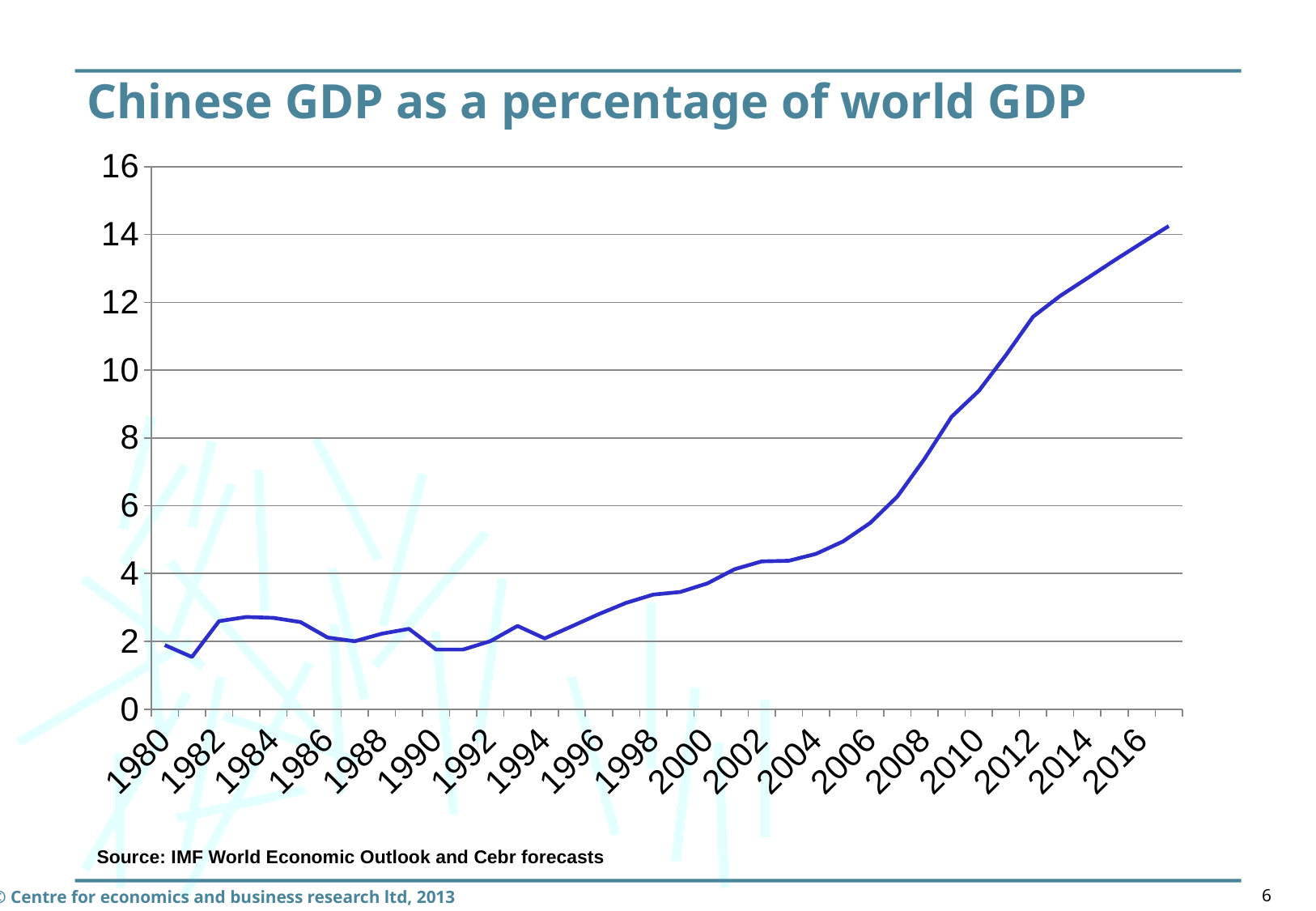
How many year labels are shown on the x axis? 19 Is the value for 2012 greater or less than 10? greater What is the title of the chart? Chinese GDP as a percentage of world GDP Is the value for 2010 greater or less than 8? greater Is the value for 1990 greater or less than 2? less Overall, does the line rise or fall from 1980 to the end of the series? rise Which year has the larger value, 1984 or 1994? 1984 What kind of chart is shown on the slide? line chart Which year has the larger value, 2000 or 2010? 2010 What source is cited below the chart? IMF World Economic Outlook and Cebr forecasts